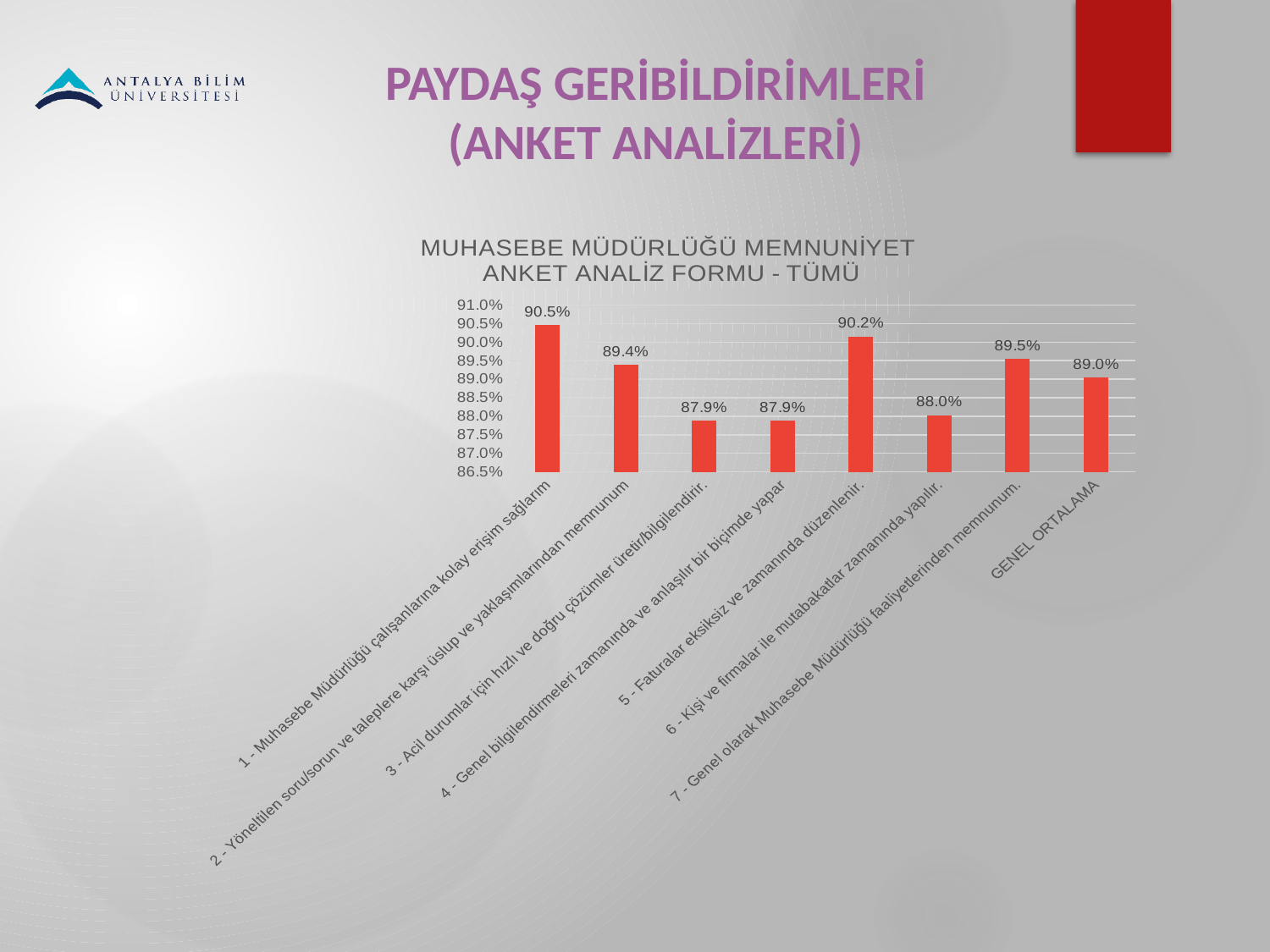
What is the value for item 6 (Kişi ve firmalar ile mutabakatlar zamanında yapılır.)? 88.0% Which is larger: the value for item 5 or the value for item 7? Item 5 (90.2%) What is the title of the chart? MUHASEBE MÜDÜRLÜĞÜ MEMNUNİYET ANKET ANALİZ FORMU - TÜMÜ Which category has the highest value? 1 - Muhasebe Müdürlüğü çalışanlarına kolay erişim sağlarım What is the value for item 2 (Yöneltilen soru/sorun ve taleplere karşı üslup ve yaklaşımlarından memnunum)? 89.4% How many bars are shown in the chart? 8 What colour are the bars in the chart? Red What is the lowest value shown in the chart? 87.9% What is the value for item 5 (Faturalar eksiksiz ve zamanında düzenlenir.)? 90.2% What kind of chart is shown on the slide? Bar chart What is the difference between the value for item 1 and the value for item 7? 1.0% What is the value for GENEL ORTALAMA? 89.0%